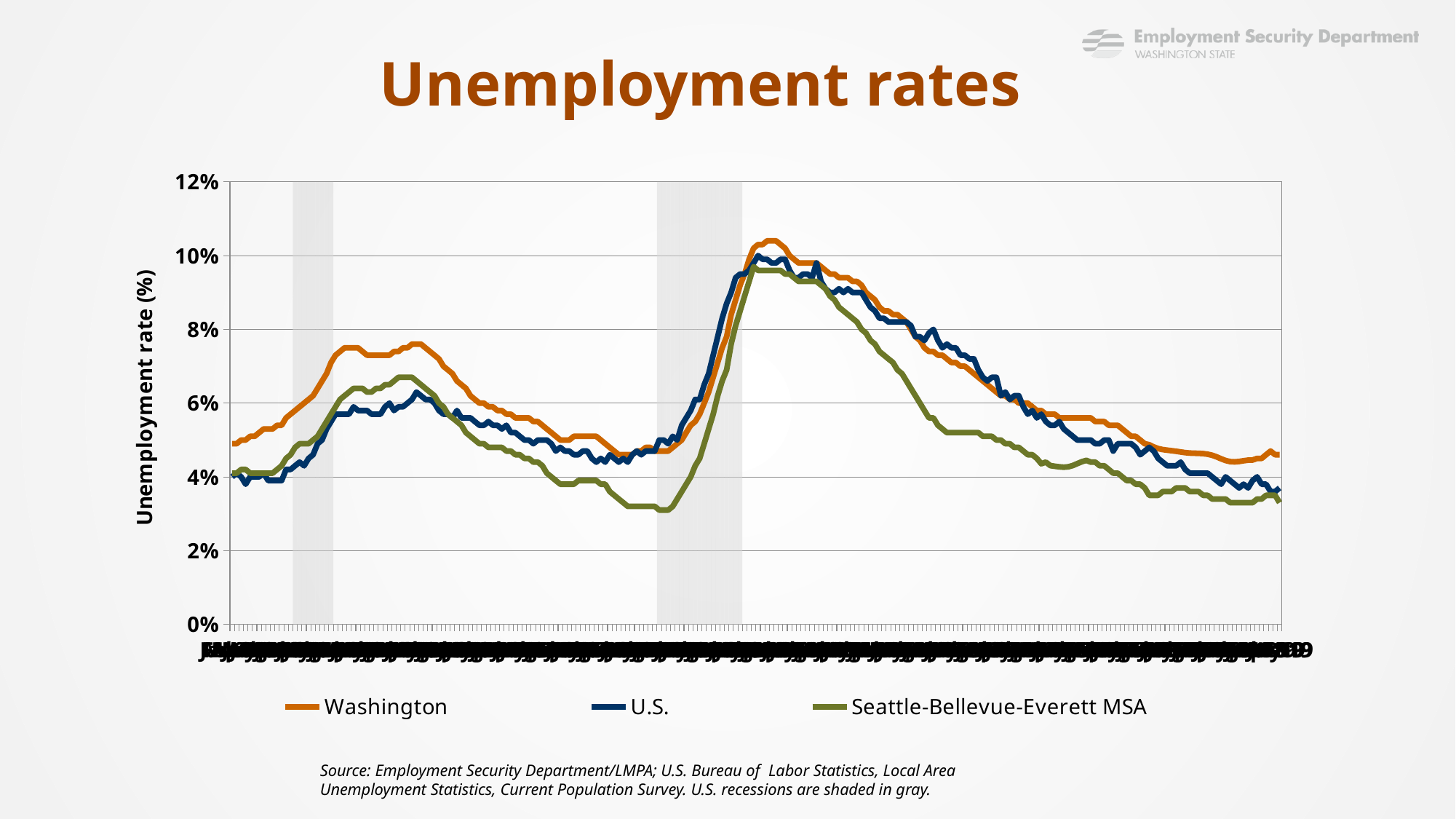
Which series reaches the highest peak on the chart? Washington How many series does the legend list? 3 At the right end of the chart, which is higher: the Washington line or the Seattle-Bellevue-Everett MSA line? Washington What is the highest value shown on the vertical axis? 12% Is the highest value of the Washington line greater or less than 10%? greater Which series has the lowest value at the right end of the chart? Seattle-Bellevue-Everett MSA After the second shaded recession, do the unemployment rates rise or fall toward the right end of the chart? fall Is the lowest value of the Seattle-Bellevue-Everett MSA line greater or less than 4%? less What kind of chart is shown on the slide? Line chart What is the label on the vertical axis of the chart? Unemployment rate (%) What is the title of the chart? Unemployment rates Is the highest value of the Seattle-Bellevue-Everett MSA line greater or less than 10%? less